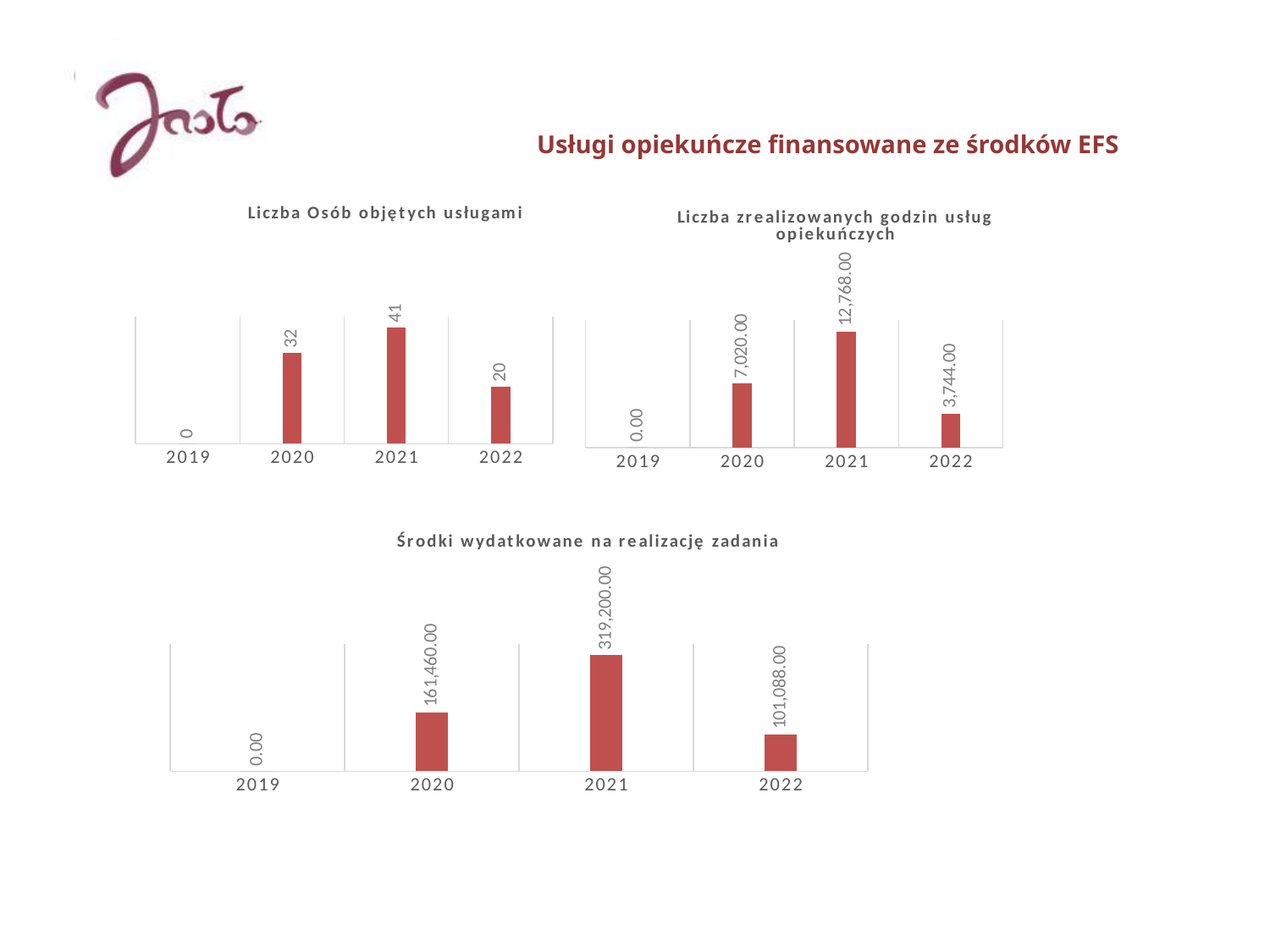
How many years are shown on the x axis of the chart titled "Środki wydatkowane na realizację zadania"? 4 In the chart titled "Liczba Osób objętych usługami", which year has the highest value? 2021 In the chart titled "Środki wydatkowane na realizację zadania", what is the value for 2022? 101,088.00 In the chart titled "Liczba zrealizowanych godzin usług opiekuńczych", what is the value for 2020? 7,020.00 In the chart titled "Liczba zrealizowanych godzin usług opiekuńczych", is the value for 2021 larger or smaller than the value for 2022? larger In the chart titled "Liczba Osób objętych usługami", what is the difference between the values for 2020 and 2022? 12 What kind of chart is the chart titled "Liczba Osób objętych usługami"? bar chart In the chart titled "Środki wydatkowane na realizację zadania", what is the difference between the values for 2021 and 2020? 157,740.00 How many charts are shown on the slide? 3 In the chart titled "Środki wydatkowane na realizację zadania", what is the value for 2021? 319,200.00 In the chart titled "Liczba zrealizowanych godzin usług opiekuńczych", which year has the lowest value? 2019 In the chart titled "Liczba Osób objętych usługami", what is the value for 2021? 41